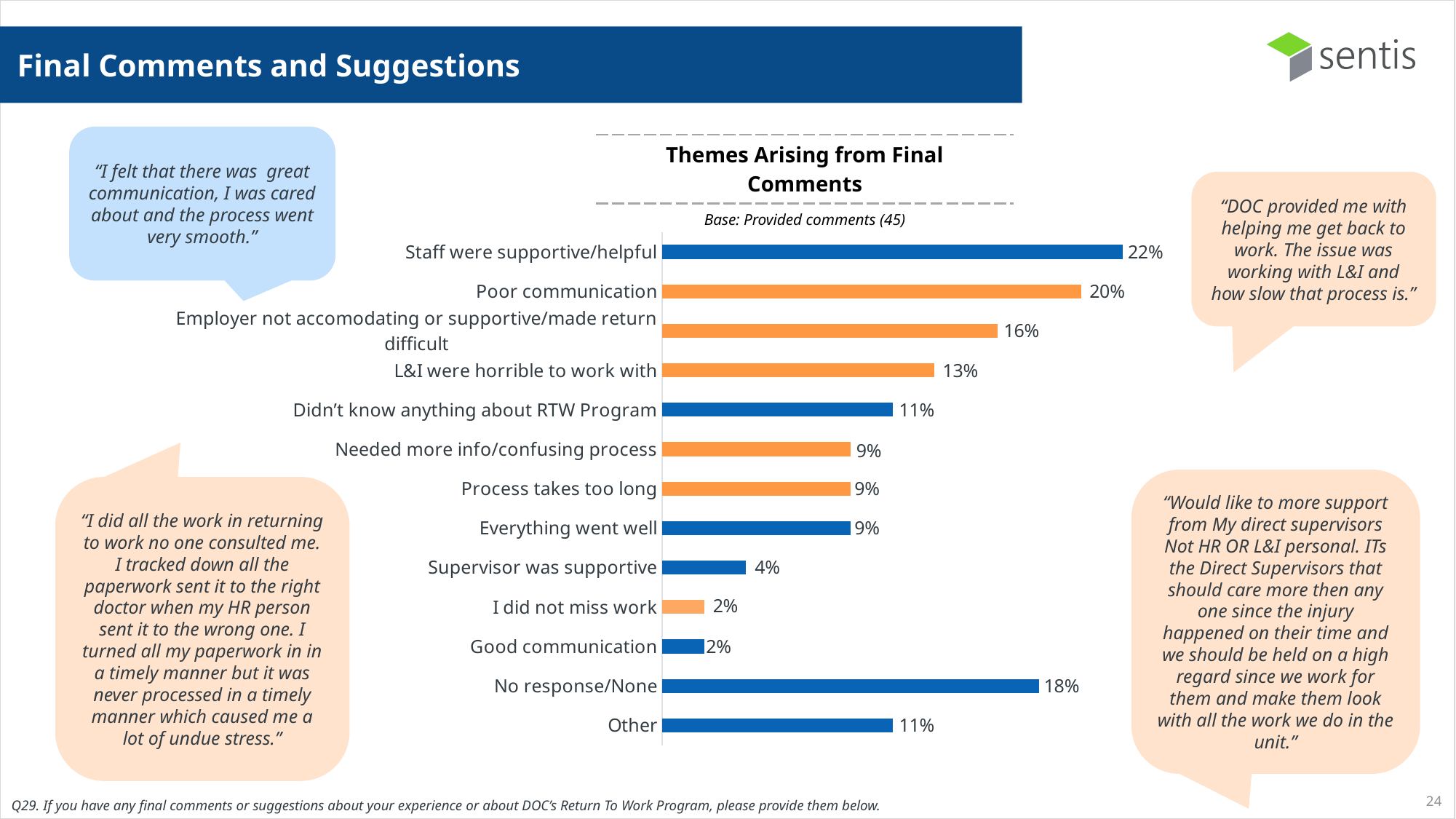
Which theme has the highest percentage in the chart? Staff were supportive/helpful How many themes (categories) are plotted in the chart? 13 What is the value shown for "Poor communication"? 20% Which is larger: the value for "Didn't know anything about RTW Program" or the value for "Supervisor was supportive"? Didn't know anything about RTW Program What percentage is shown for "L&I were horrible to work with"? 13% What is the title of the chart? Themes Arising from Final Comments What kind of chart is used to show the themes arising from final comments? Bar chart What is the base (number of respondents) stated for the chart? Provided comments (45) What is the difference between the values for "Poor communication" and "Employer not accomodating or supportive/made return difficult"? 4% What is the difference between the values for "Staff were supportive/helpful" and "Everything went well"? 13% What percentage of comments fell under the theme "Staff were supportive/helpful"? 22% What is the value for "No response/None"? 18%